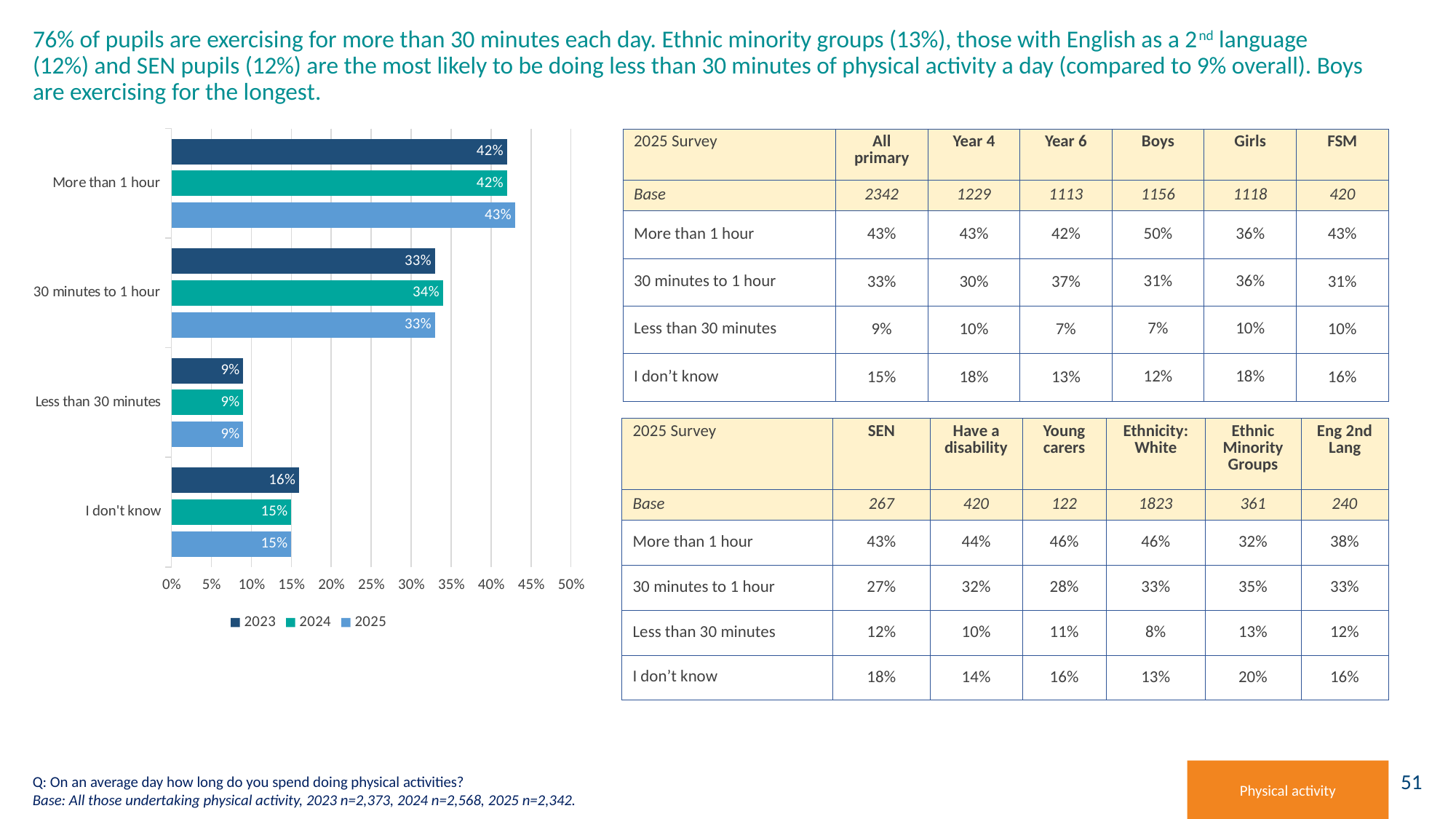
How many categories are shown on the chart? 4 Which category has the lowest value for the 2023 series? Less than 30 minutes What is the 2025 value for "More than 1 hour"? 43% What is the difference between the 2025 values for "More than 1 hour" and "30 minutes to 1 hour"? 10 percentage points Which is larger: the 2023 value for "I don't know" or the 2024 value for "I don't know"? 2023 Which category has the highest value for the 2025 series? More than 1 hour What kind of chart is shown on the slide? Bar chart Is the 2024 value for "More than 1 hour" greater or less than 40%? greater What is the 2025 value for "Less than 30 minutes"? 9% What is the 2024 value for "30 minutes to 1 hour"? 34% How many series does the legend list? 3 What is the 2023 value for "I don't know"? 16%